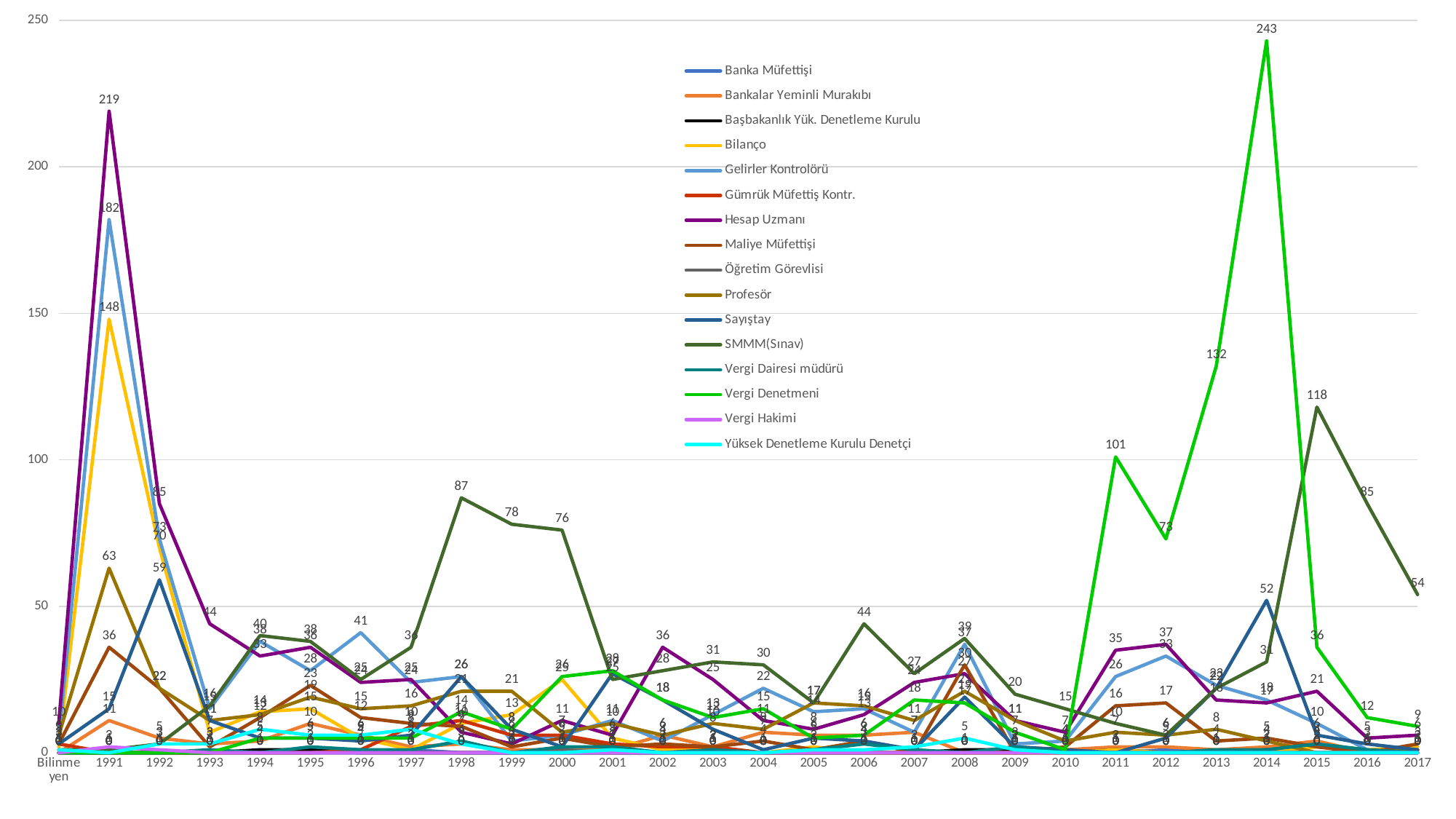
Which series reaches the highest value anywhere on the chart? Vergi Denetmeni What kind of chart is shown on the slide? line chart What is the value for SMMM(Sınav) in 2015? 118 What is the value for Hesap Uzmanı in 1991? 219 What is the value for Vergi Denetmeni in 2014? 243 What is the difference between the Vergi Denetmeni value in 2014 and the Hesap Uzmanı value in 1991? 24 How many series does the legend list? 16 Is the value for SMMM(Sınav) in 1998 greater or less than 50? greater In 1991, which is larger: Gelirler Kontrolörü or Bilanço? Gelirler Kontrolörü What is the value for Vergi Denetmeni in 2011? 101 How many categories are shown along the x axis (including 'Bilinmeyen')? 28 Does the Vergi Denetmeni line rise or fall from 2014 to 2017? fall